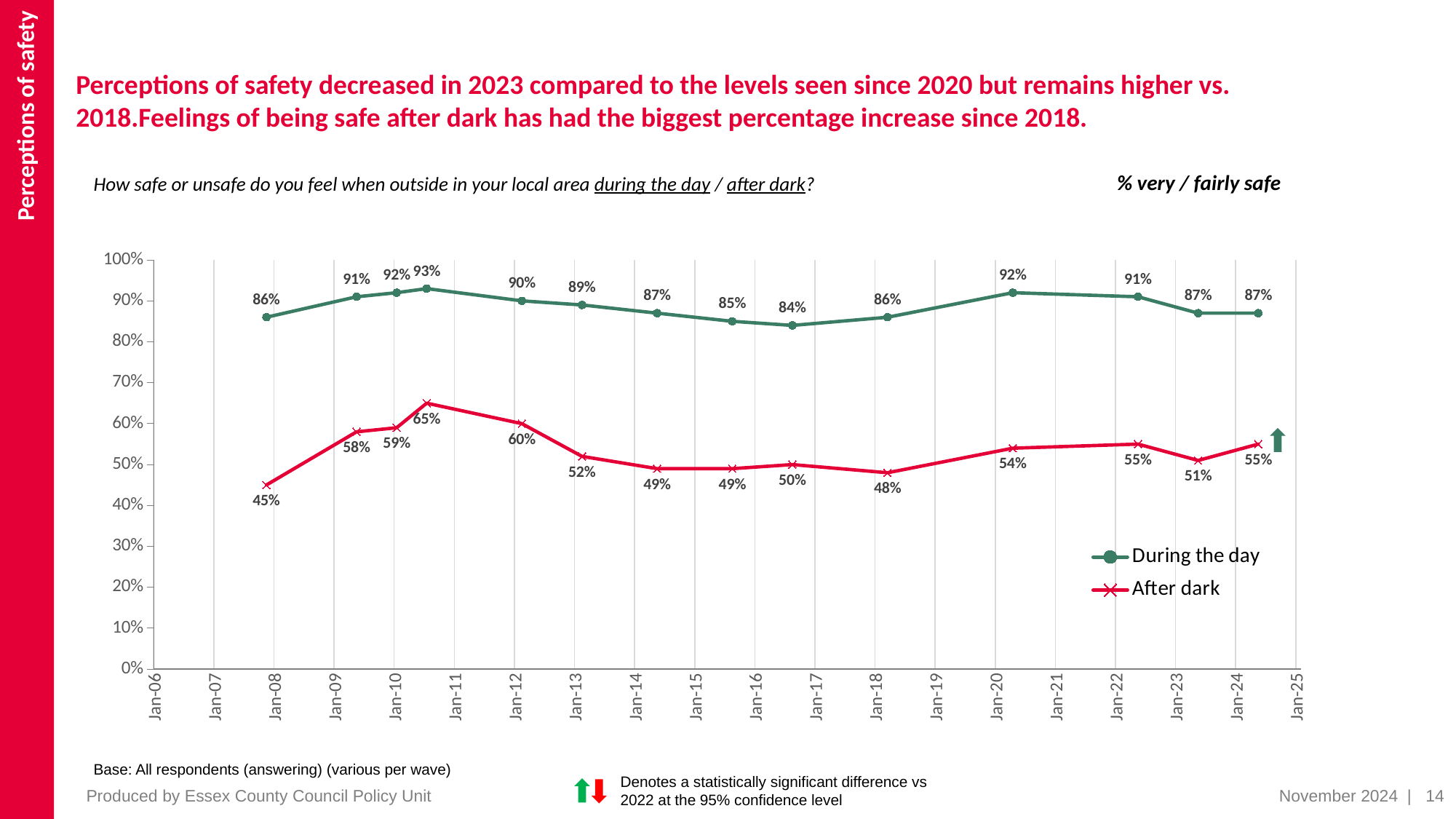
What is the highest value shown for the During the day series? 93% What is the value of the most recent (rightmost) point for the During the day series? 87% Which series has higher values throughout the chart, During the day or After dark? During the day What is the lowest value shown for the During the day series? 84% What is the value of the most recent (rightmost) point for the After dark series? 55% What is the lowest value shown for the After dark series? 45% How many data points are plotted for the After dark series? 14 How many series does the legend list? 2 What is the highest value shown for the After dark series? 65% What are the two series named in the legend? During the day; After dark What is the difference between the first After dark value (45%) and the first During the day value (86%)? 41 percentage points What kind of chart is shown on the slide? line chart